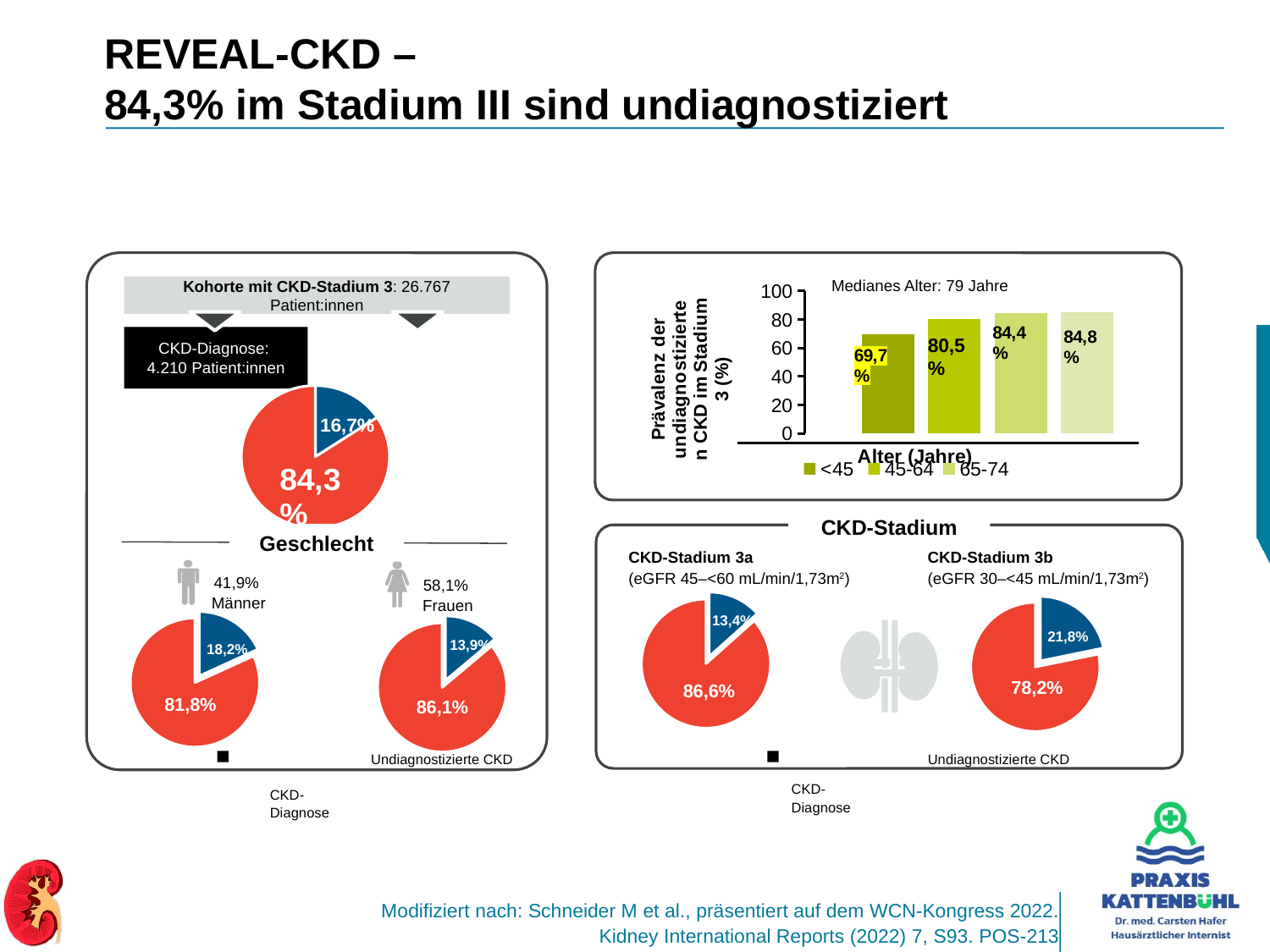
In the CKD-Stadium pie charts, what is the undiagnosed CKD share for CKD-Stadium 3b? 78,2% In the Geschlecht pie charts, what is the undiagnosed CKD share for Männer? 81,8% In the bar chart of prevalence of undiagnosed CKD by age, do the values rise or fall with increasing age? rise In the Geschlecht pie charts, which group has the larger undiagnosed CKD share, Männer or Frauen? Frauen In the large pie chart on the left panel, what share of the CKD stage 3 cohort is undiagnosed CKD? 84,3% In the Geschlecht pie charts, what is the difference between the CKD-Diagnose shares of Männer and Frauen? 4,3% In the bar chart of prevalence of undiagnosed CKD by age, what is the value for the 45-64 age group? 80,5% In the bar chart of prevalence of undiagnosed CKD by age, which labelled age group has the lowest value? <45 In the Geschlecht pie charts, what is the CKD-Diagnose share for Frauen? 13,9% In the large pie chart on the left panel, what share has a CKD diagnosis? 16,7% In the CKD-Stadium pie charts, what is the difference between the CKD-Diagnose shares of CKD-Stadium 3b and CKD-Stadium 3a? 8,4% In the bar chart of prevalence of undiagnosed CKD by age, what is the value for the <45 age group? 69,7%